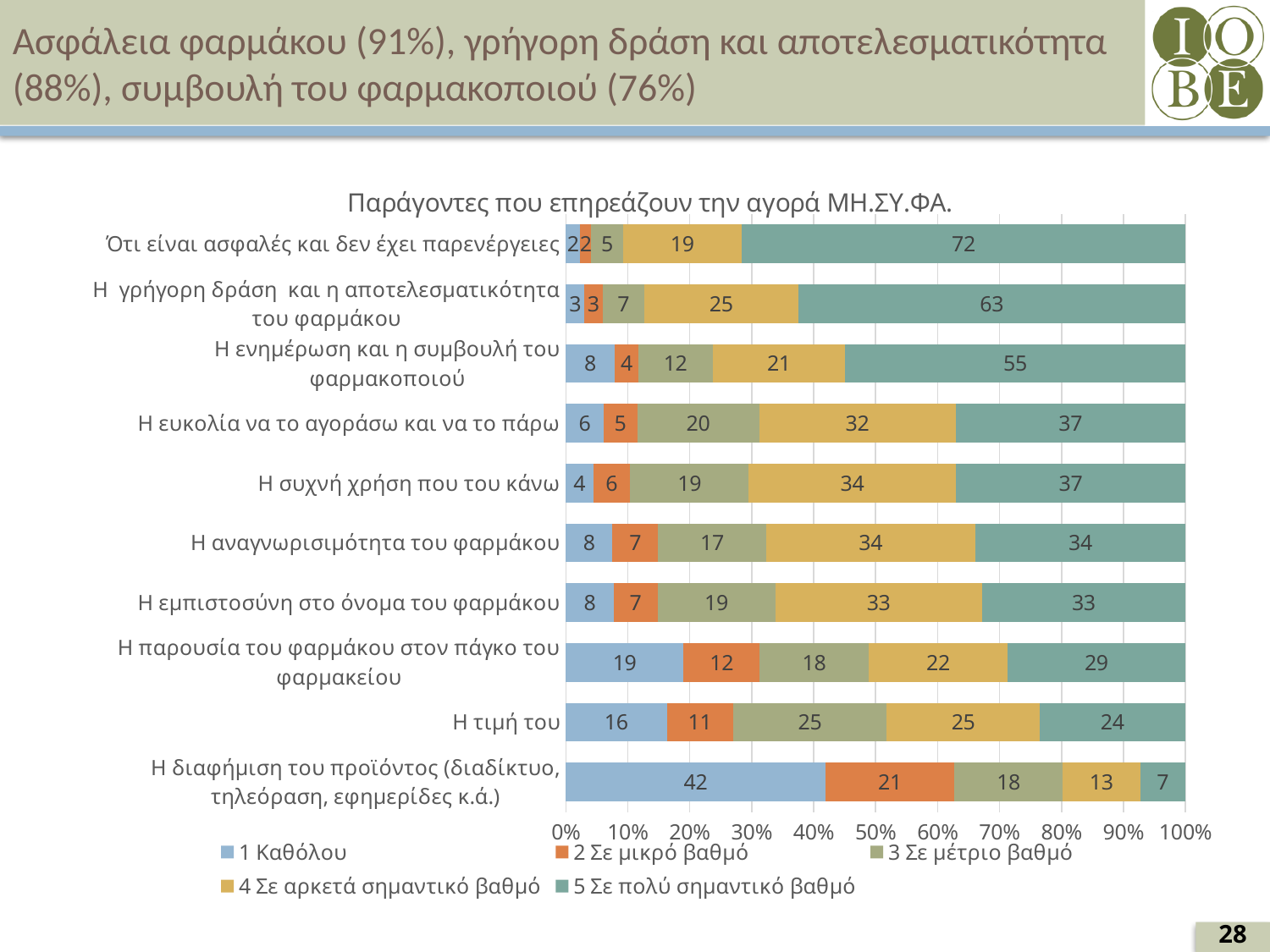
Which category has the highest value for "5 Σε πολύ σημαντικό βαθμό"? Ότι είναι ασφαλές και δεν έχει παρενέργειες Which category has the lowest value for "5 Σε πολύ σημαντικό βαθμό"? Η διαφήμιση του προϊόντος (διαδίκτυο, τηλεόραση, εφημερίδες κ.ά.) What is the title of the chart? Παράγοντες που επηρεάζουν την αγορά ΜΗ.ΣΥ.ΦΑ. How many series does the legend list? 5 What is the value of "1 Καθόλου" for "Η διαφήμιση του προϊόντος (διαδίκτυο, τηλεόραση, εφημερίδες κ.ά.)"? 42 How many categories are shown in the chart? 10 What is the value of "5 Σε πολύ σημαντικό βαθμό" for "Ότι είναι ασφαλές και δεν έχει παρενέργειες"? 72 What is the value of "3 Σε μέτριο βαθμό" for "Η τιμή του"? 25 What is the difference between the "5 Σε πολύ σημαντικό βαθμό" values for "Ότι είναι ασφαλές και δεν έχει παρενέργειες" and "Η γρήγορη δράση και η αποτελεσματικότητα του φαρμάκου"? 9 What kind of chart is shown on the slide? Stacked bar chart What is the value of "4 Σε αρκετά σημαντικό βαθμό" for "Η συχνή χρήση που του κάνω"? 34 Which has a larger "1 Καθόλου" value: "Η παρουσία του φαρμάκου στον πάγκο του φαρμακείου" or "Η τιμή του"? Η παρουσία του φαρμάκου στον πάγκο του φαρμακείου